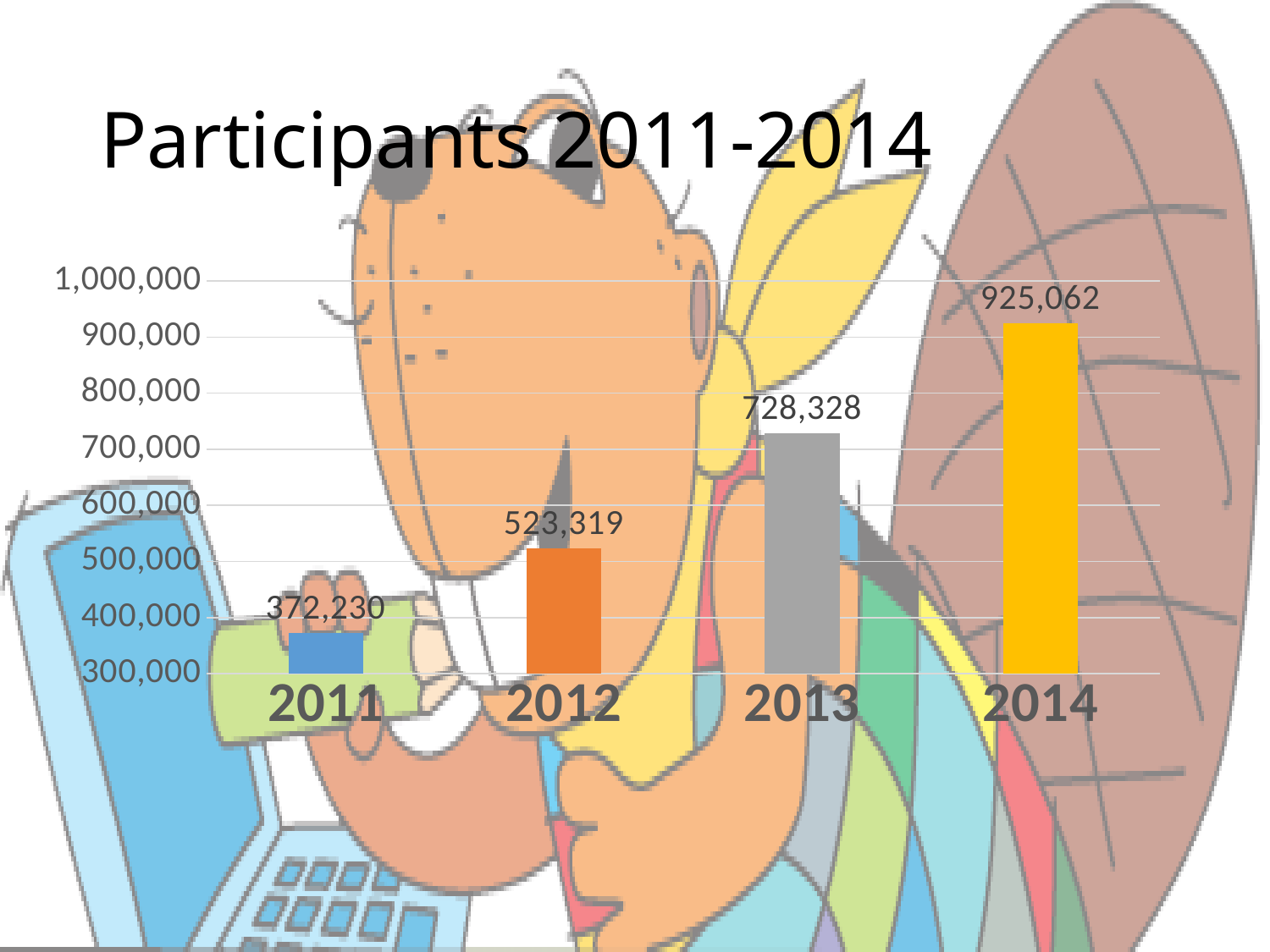
Do the participant numbers rise or fall from 2011 to 2014? rise Which year has the highest number of participants? 2014 How many years are shown on the chart? 4 What is the difference in participants between 2012 and 2011? 151,089 What is the difference in participants between 2014 and 2013? 196,734 What is the number of participants in 2011? 372,230 What kind of chart is shown on the slide? bar chart Which year had more participants, 2012 or 2013? 2013 What is the number of participants in 2013? 728,328 Is the value for 2012 greater or less than 500,000? greater Which year has the lowest number of participants? 2011 What is the number of participants in 2014? 925,062